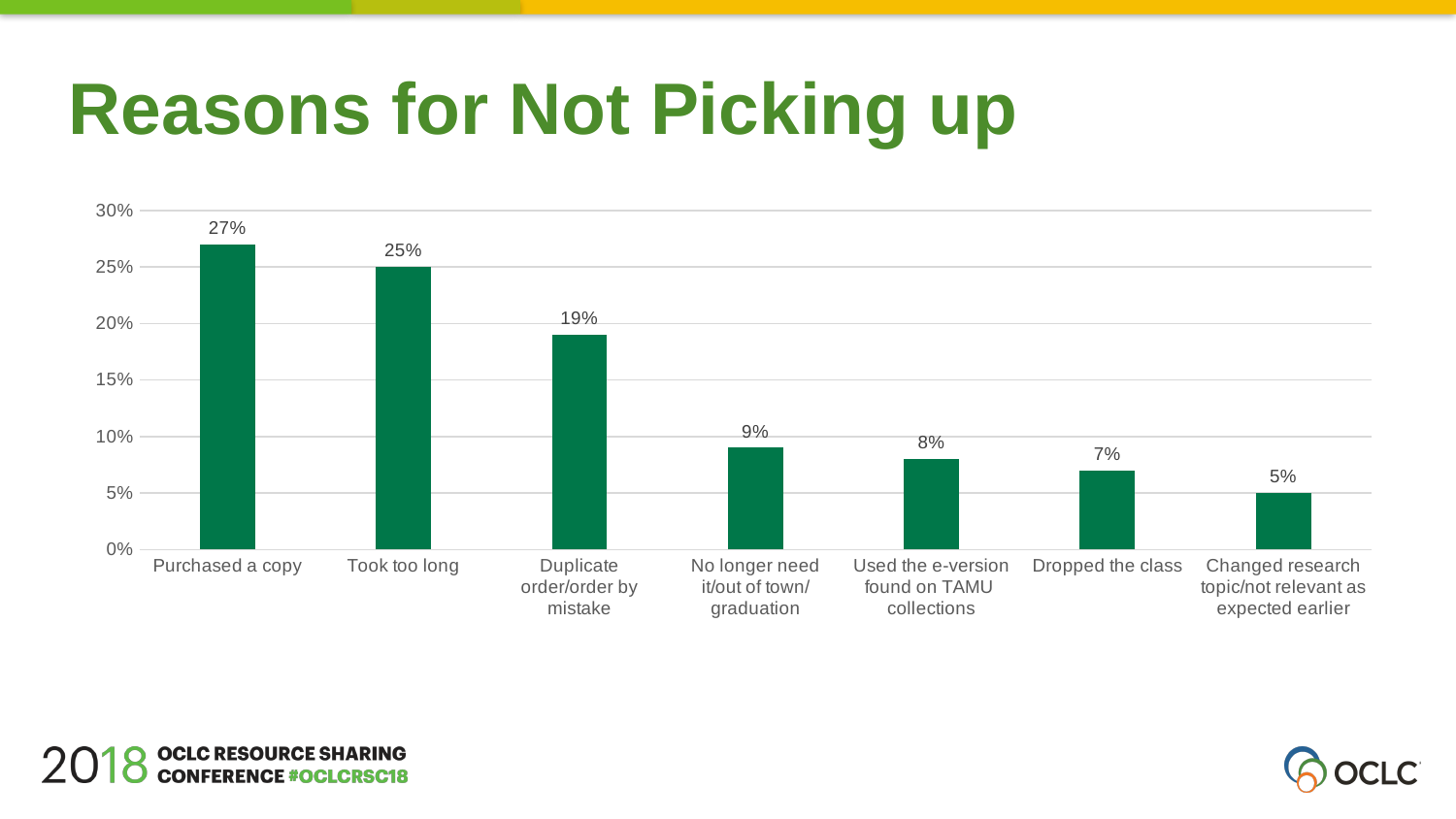
Which is larger: "No longer need it/out of town/graduation" or "Dropped the class"? No longer need it/out of town/graduation What is the difference between "Duplicate order/order by mistake" and "Dropped the class"? 12% Which reason has the lowest percentage? Changed research topic/not relevant as expected earlier What is the title of the slide? Reasons for Not Picking up What is the value for "Took too long"? 25% Do the values rise or fall from left to right across the categories? Fall What kind of chart is shown on the slide? Bar chart How many reasons are shown in the chart? 7 What is the value for "Used the e-version found on TAMU collections"? 8% Which reason has the highest percentage? Purchased a copy What percentage of respondents gave "Purchased a copy" as a reason for not picking up? 27% What is the difference between "Purchased a copy" and "Took too long"? 2%